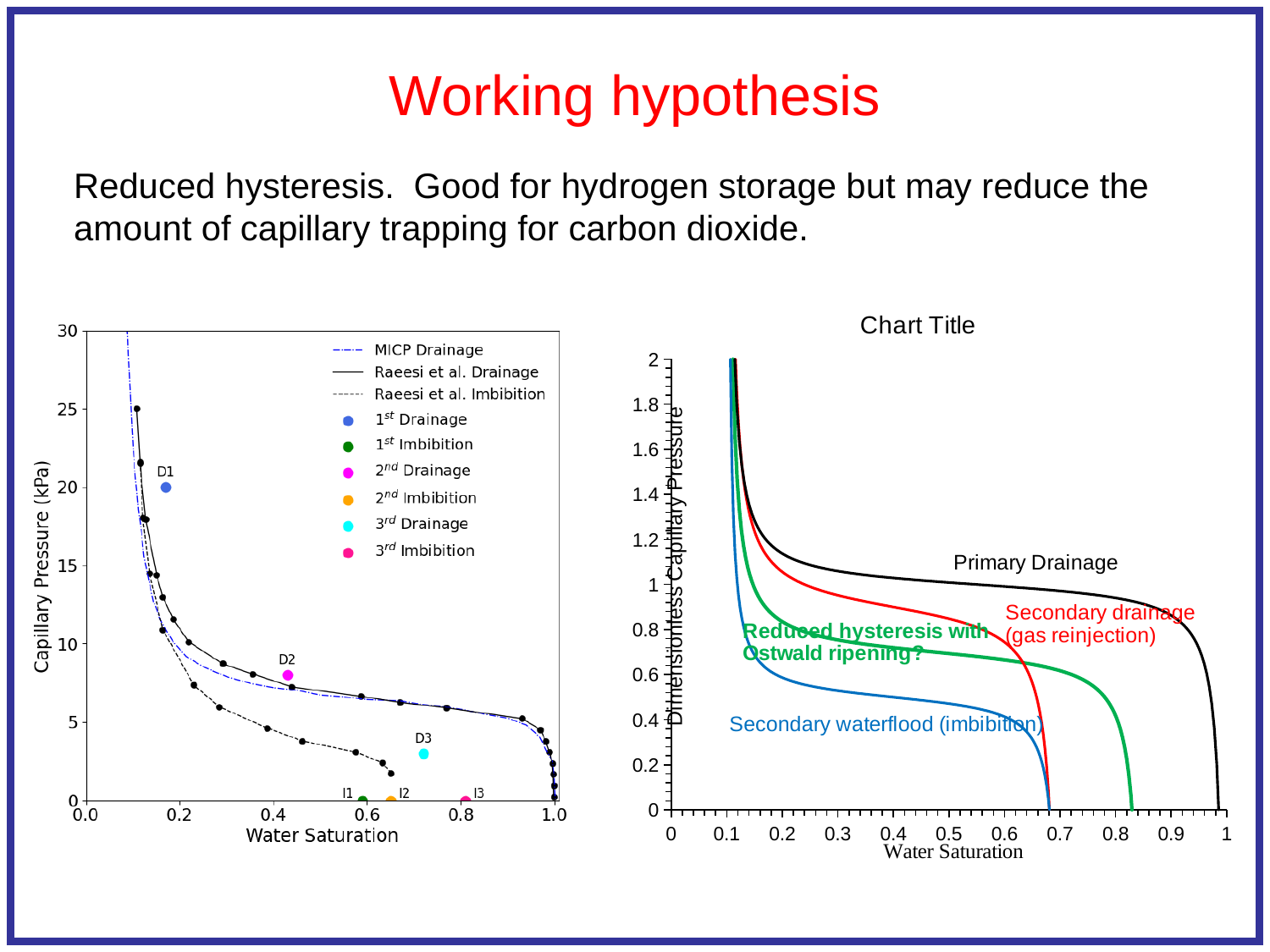
On the left chart, does the Raeesi et al. Drainage curve rise or fall as water saturation increases? fall On the right chart, how many curves are plotted? 4 On the left chart, is the capillary pressure of point D3 greater or less than 5 kPa? less On the left chart, is the capillary pressure of point D2 greater or less than 10 kPa? less On the left chart, is the capillary pressure of point D1 greater or less than 15 kPa? greater On the left chart, how many entries does the legend list? 9 On the right chart, which curve reaches the highest water saturation at zero dimensionless capillary pressure? Primary Drainage On the left chart, what is the highest value shown on the capillary pressure axis? 30 On the left chart, what is the label of the y axis? Capillary Pressure (kPa) On the left chart, which point has the higher capillary pressure, D1 or D2? D1 On the right chart, which curve reaches the lowest water saturation at zero dimensionless capillary pressure? Secondary waterflood (imbibition)